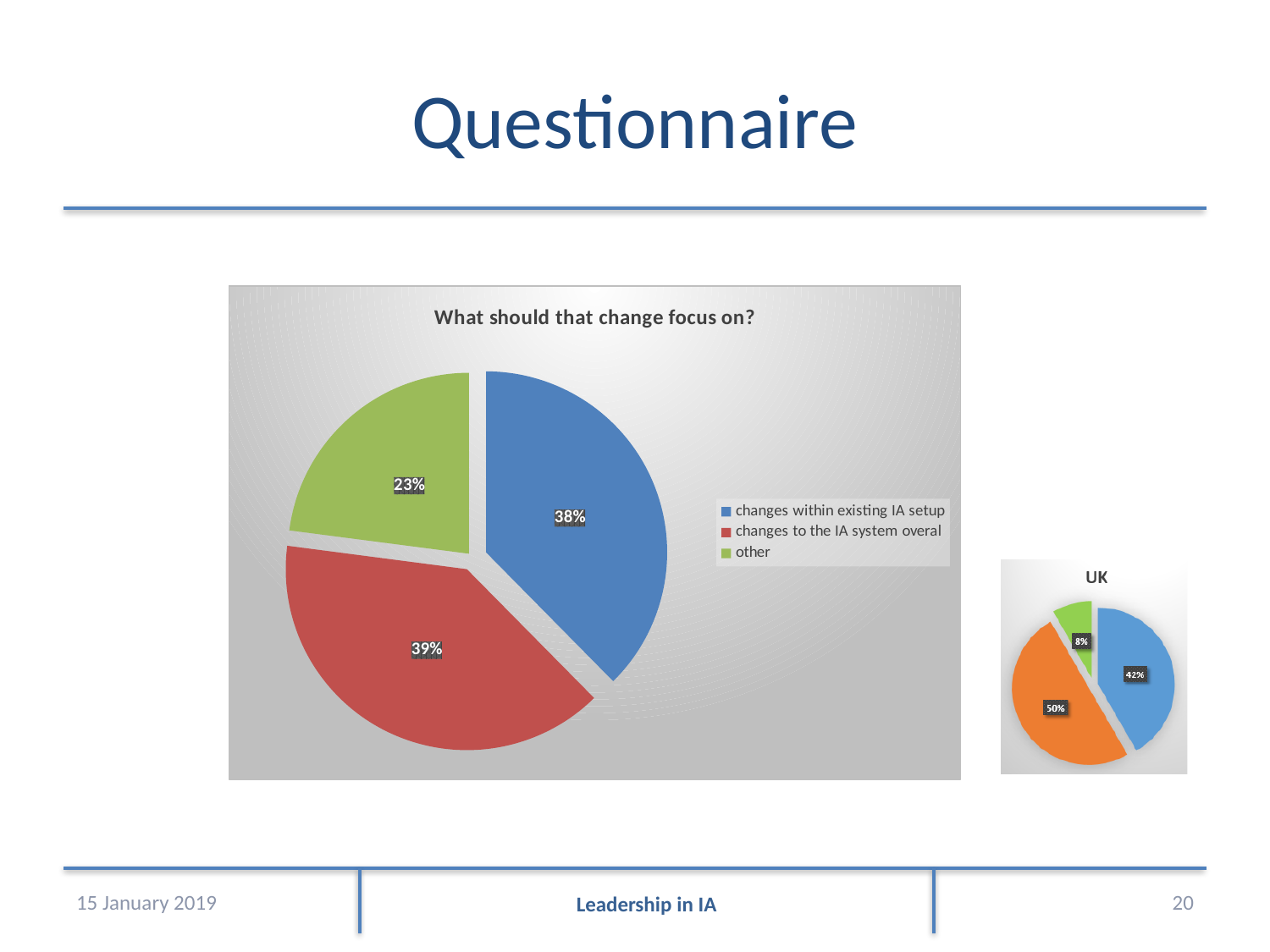
In the small chart titled "UK", what share is shown on the green slice? 8% In the chart titled "What should that change focus on?", what share is shown for "changes to the IA system overal"? 39% What kind of chart is the chart titled "What should that change focus on?"? pie chart In the chart titled "What should that change focus on?", what is the difference between the shares for "changes to the IA system overal" and "other"? 16% In the chart titled "What should that change focus on?", which category has the smallest slice? other In the chart titled "What should that change focus on?", what share is shown for "changes within existing IA setup"? 38% How many categories does the legend of the chart titled "What should that change focus on?" list? 3 In the chart titled "What should that change focus on?", which is larger: "changes to the IA system overal" or "other"? changes to the IA system overal In the chart titled "What should that change focus on?", which colour represents "other"? green In the small chart titled "UK", what share is shown on the orange slice? 50% In the chart titled "What should that change focus on?", what share is shown for "other"? 23% In the small chart titled "UK", what share is shown on the blue slice? 42%